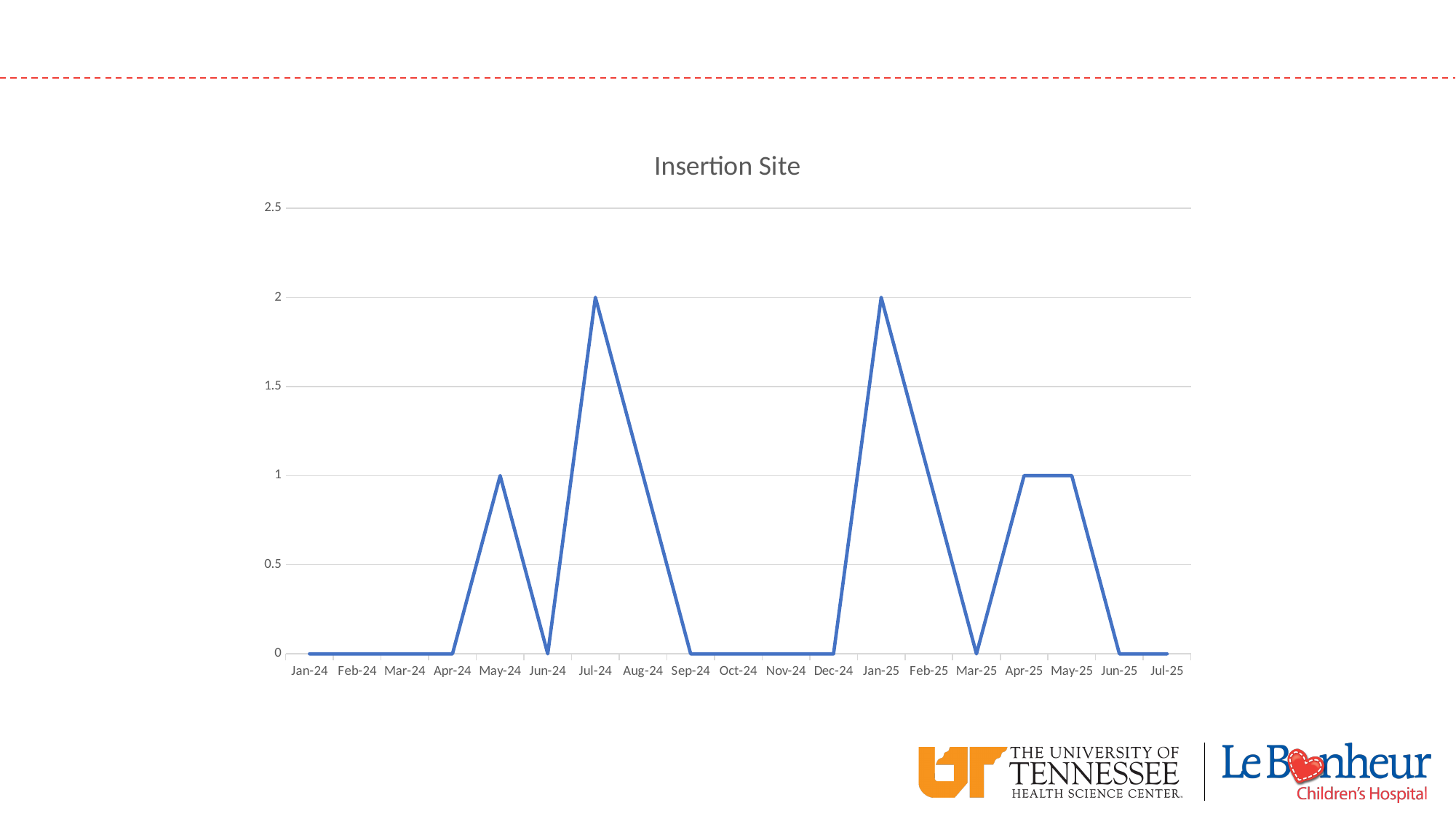
What kind of chart is shown on the slide? line chart What is the value for Jan-25? 2 Is the value for Jul-24 greater or less than 1.5? greater What is the value for Jul-25? 0 What is the title of the chart? Insertion Site Which is larger, the value for Jul-24 or the value for May-24? Jul-24 What is the value for Oct-24? 0 What is the value for Apr-25? 1 What is the value for May-24? 1 What is the value for Jul-24? 2 How many months are plotted on the x axis? 19 What is the difference between the value for Jan-25 and the value for Apr-25? 1